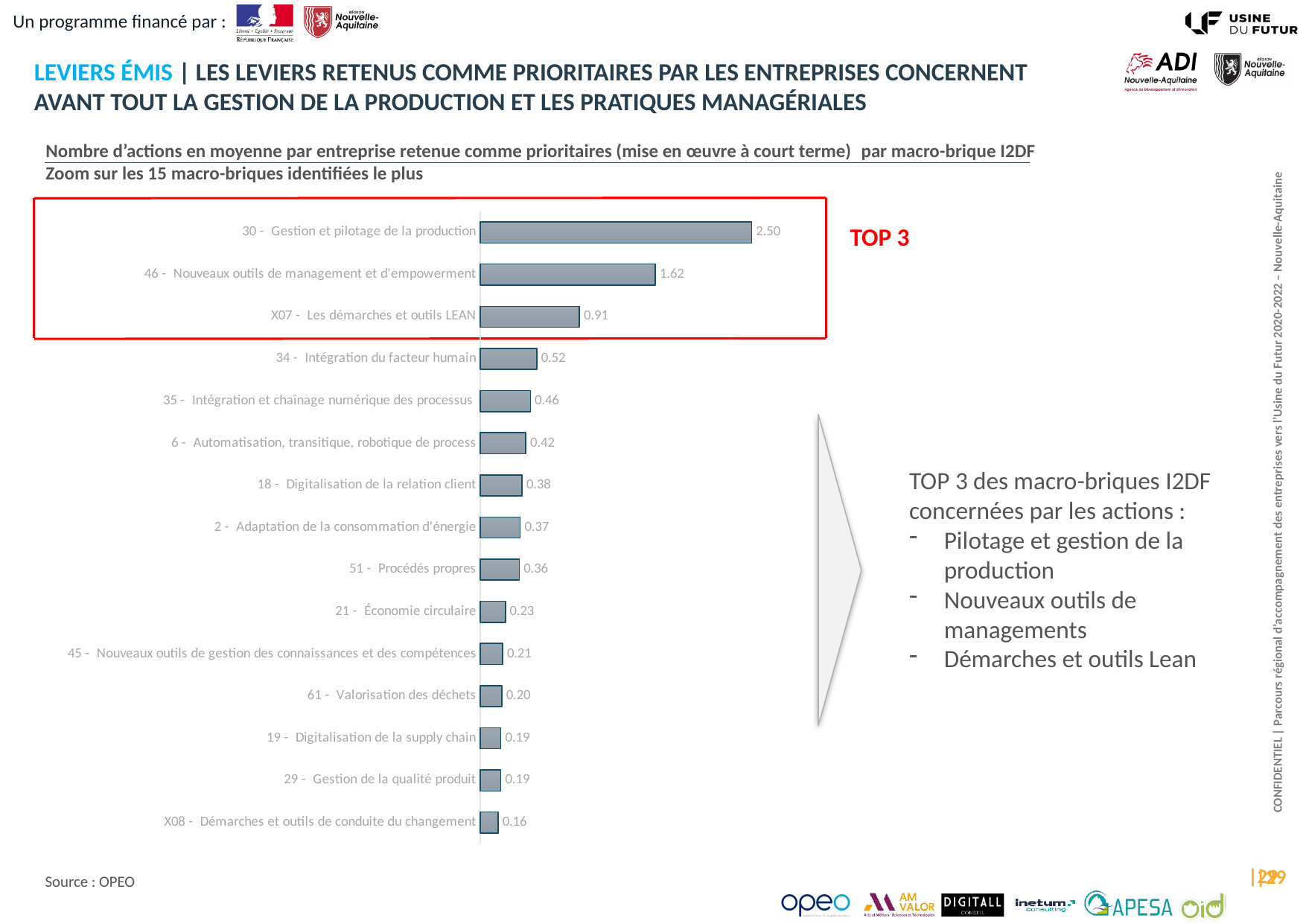
How many categories are shown in the chart? 15 How many categories are enclosed in the red 'TOP 3' box on the chart? 3 Which is larger: the value for '34 - Intégration du facteur humain' or the value for '35 - Intégration et chaînage numérique des processus'? 34 - Intégration du facteur humain What is the value for '6 - Automatisation, transitique, robotique de process'? 0.42 Which category has the highest value? 30 - Gestion et pilotage de la production Which category has the lowest value? X08 - Démarches et outils de conduite du changement What is the difference between the values for 'X07 - Les démarches et outils LEAN' and '34 - Intégration du facteur humain'? 0.39 What is the value for 'X07 - Les démarches et outils LEAN'? 0.91 What is the difference between the values for '30 - Gestion et pilotage de la production' and '46 - Nouveaux outils de management et d'empowerment'? 0.88 What kind of chart is shown on the slide? Bar chart What is the value for '21 - Économie circulaire'? 0.23 What is the value for '30 - Gestion et pilotage de la production'? 2.50